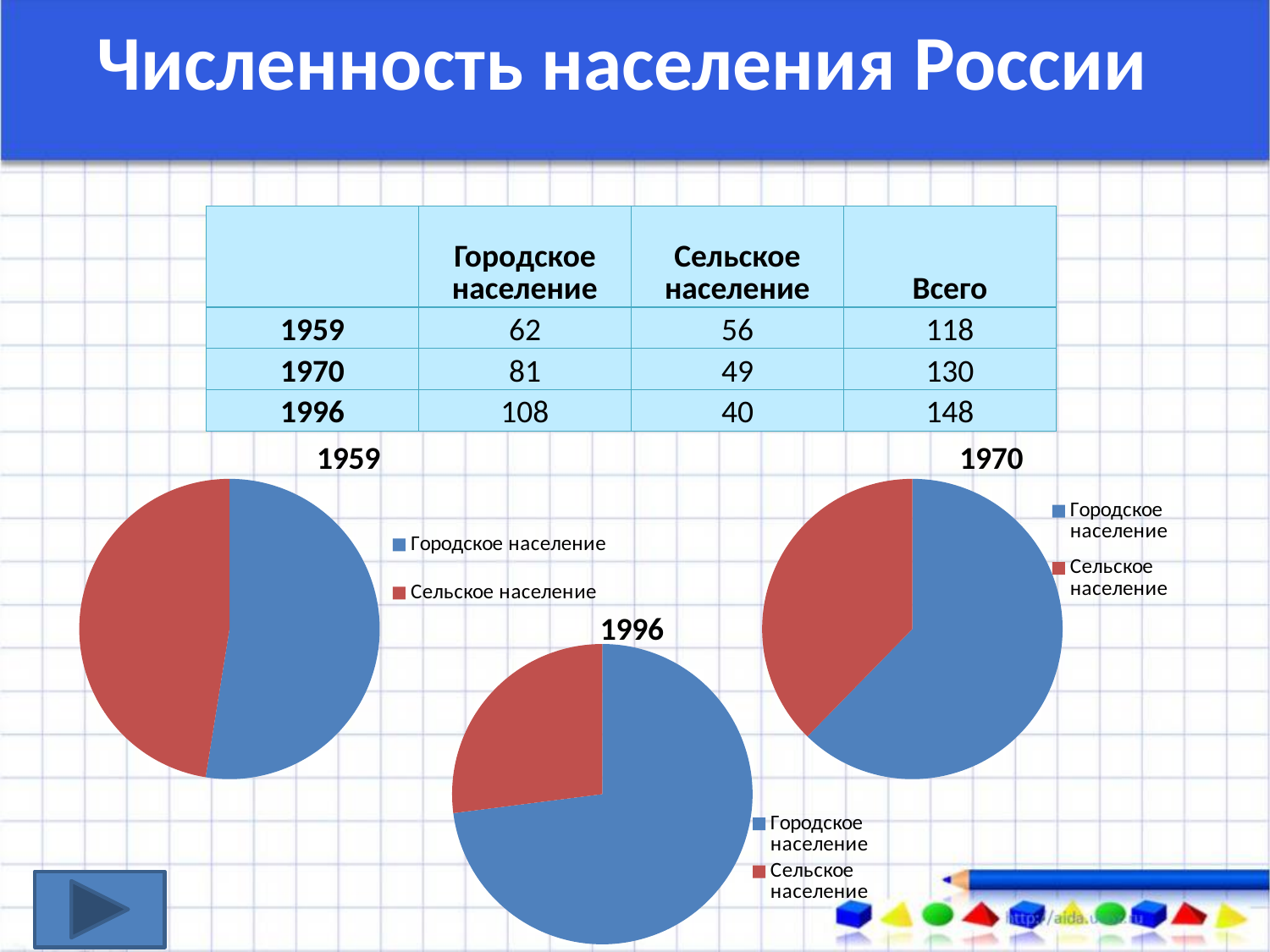
How many slices does the pie chart titled 1970 have? 2 What kind of chart is the chart titled 1959? pie chart How many series does the legend of the chart titled 1996 list? 2 In the chart titled 1959, which is larger, Городское население or Сельское население? Городское население In the chart titled 1996, which slice is the largest? Городское население What colour is the Городское население slice in the pie charts? blue Across the charts 1959, 1970 and 1996, does the value for Сельское население rise or fall? fall What is the total of the two slices in the chart titled 1959? 118 In the chart titled 1996, what is the value for Городское население? 108 In the chart titled 1996, what is the difference between Городское население and Сельское население? 68 In the chart titled 1970, which slice is the smallest? Сельское население In the chart titled 1970, what is the value for Сельское население? 49